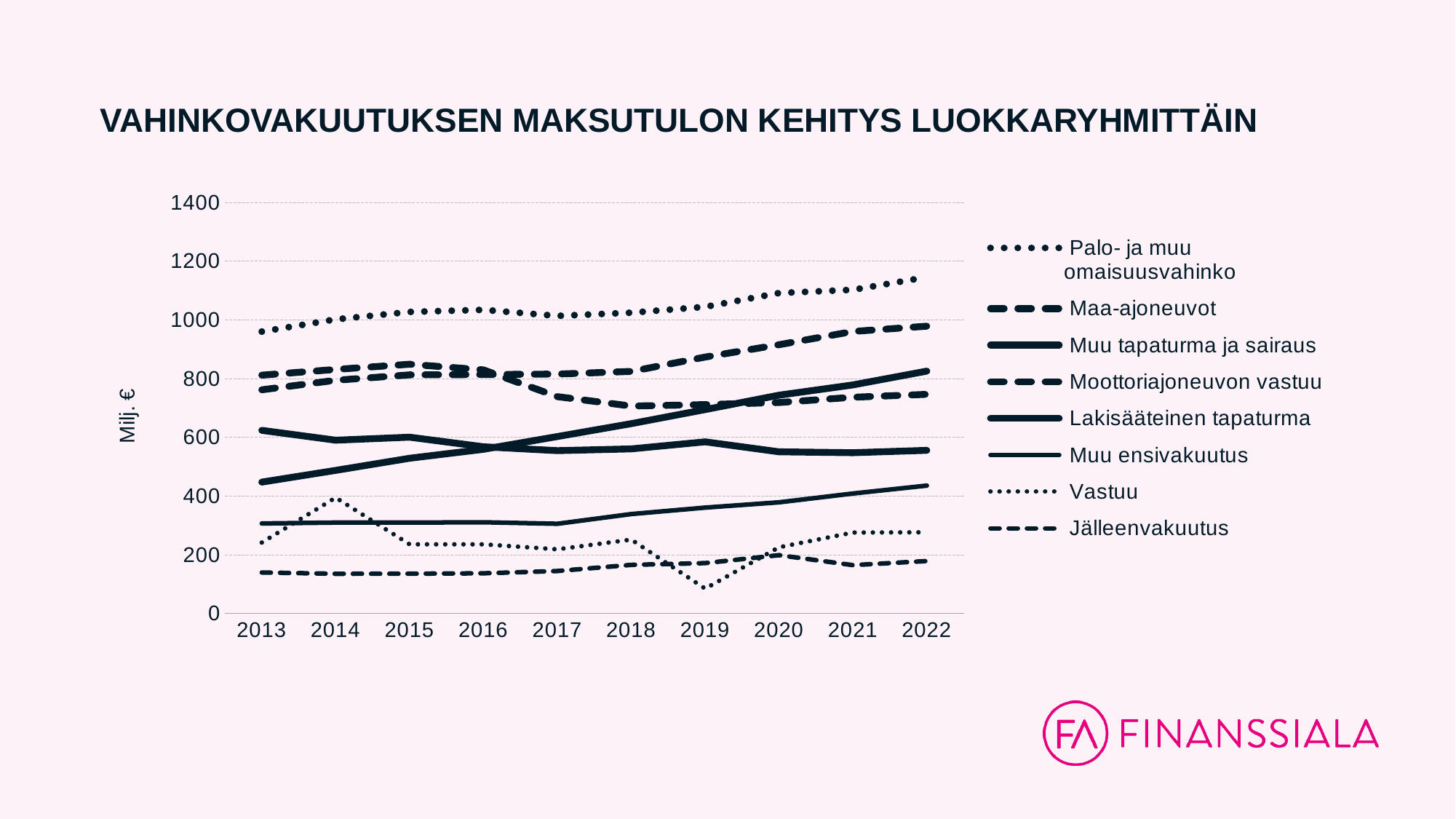
How many series does the legend list? 8 How many years are shown on the x axis? 10 What is the label on the y axis? Milj. € Is the value for Palo- ja muu omaisuusvahinko in 2022 greater or less than 1000? greater Is the value for Vastuu in 2019 greater or less than 200? less What kind of chart is shown on the slide? line chart Is the value for Muu tapaturma ja sairaus in 2022 greater or less than 600? greater Does the value for Muu tapaturma ja sairaus rise or fall from 2013 to 2022? rise Which series has the lowest value in 2013? Jälleenvakuutus In 2022, which is larger: Maa-ajoneuvot or Moottoriajoneuvon vastuu? Maa-ajoneuvot Which series has the highest value in 2022? Palo- ja muu omaisuusvahinko